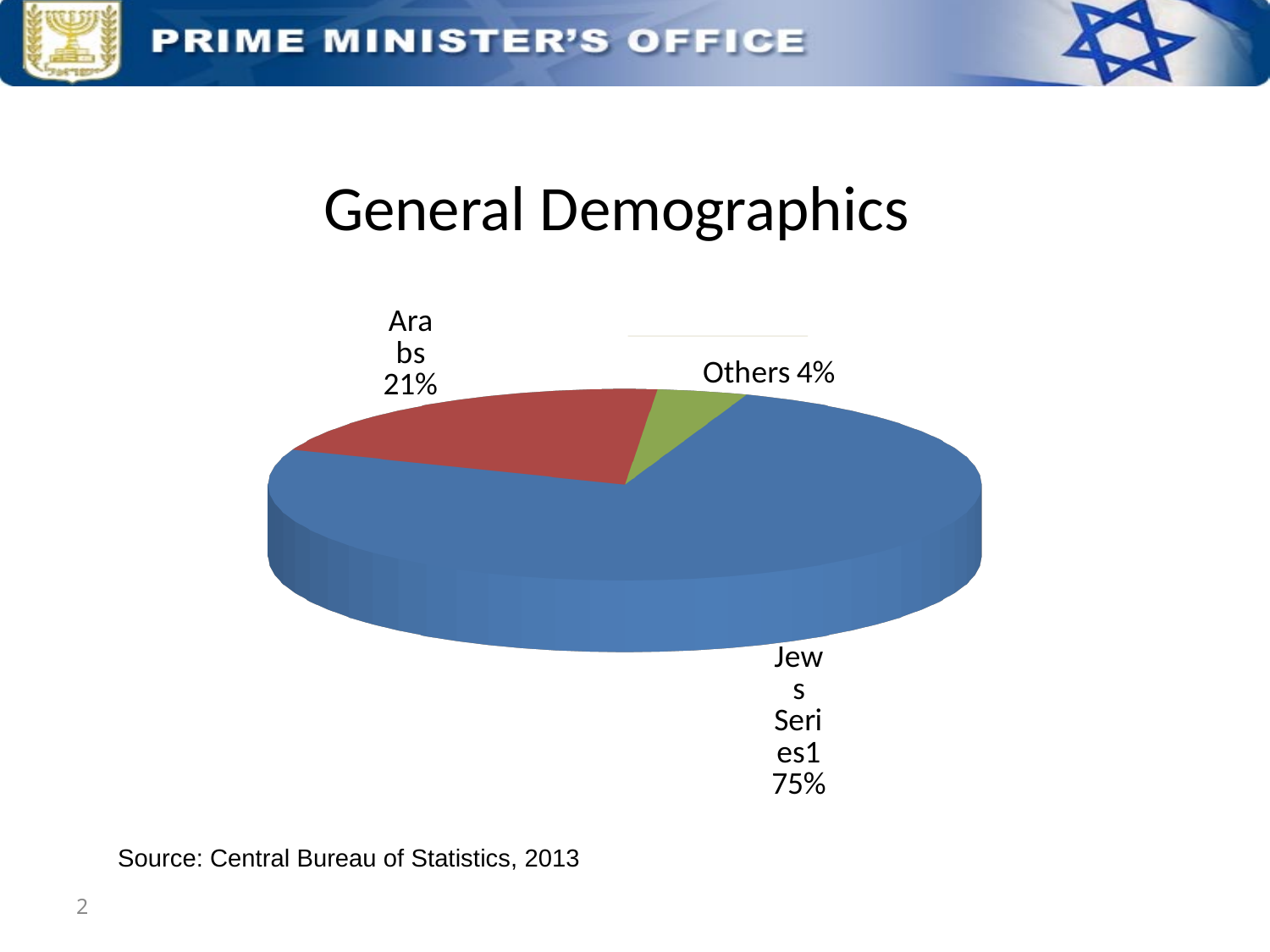
How many slices does the pie chart have? 3 Which slice of the pie is the smallest? Others What is the difference in percentage points between the Arabs slice and the Others slice? 17 What share of the pie does the Jews slice represent? 75% What share of the pie does the Others slice represent? 4% Which slice of the pie is the largest? Jews What is the difference in percentage points between the Jews slice and the Arabs slice? 54 Which is larger, the Arabs slice or the Others slice? Arabs What share of the pie does the Arabs slice represent? 21% What source is cited below the pie chart? Central Bureau of Statistics, 2013 What kind of chart is shown on the slide? pie chart What is the title of the slide containing the pie chart? General Demographics